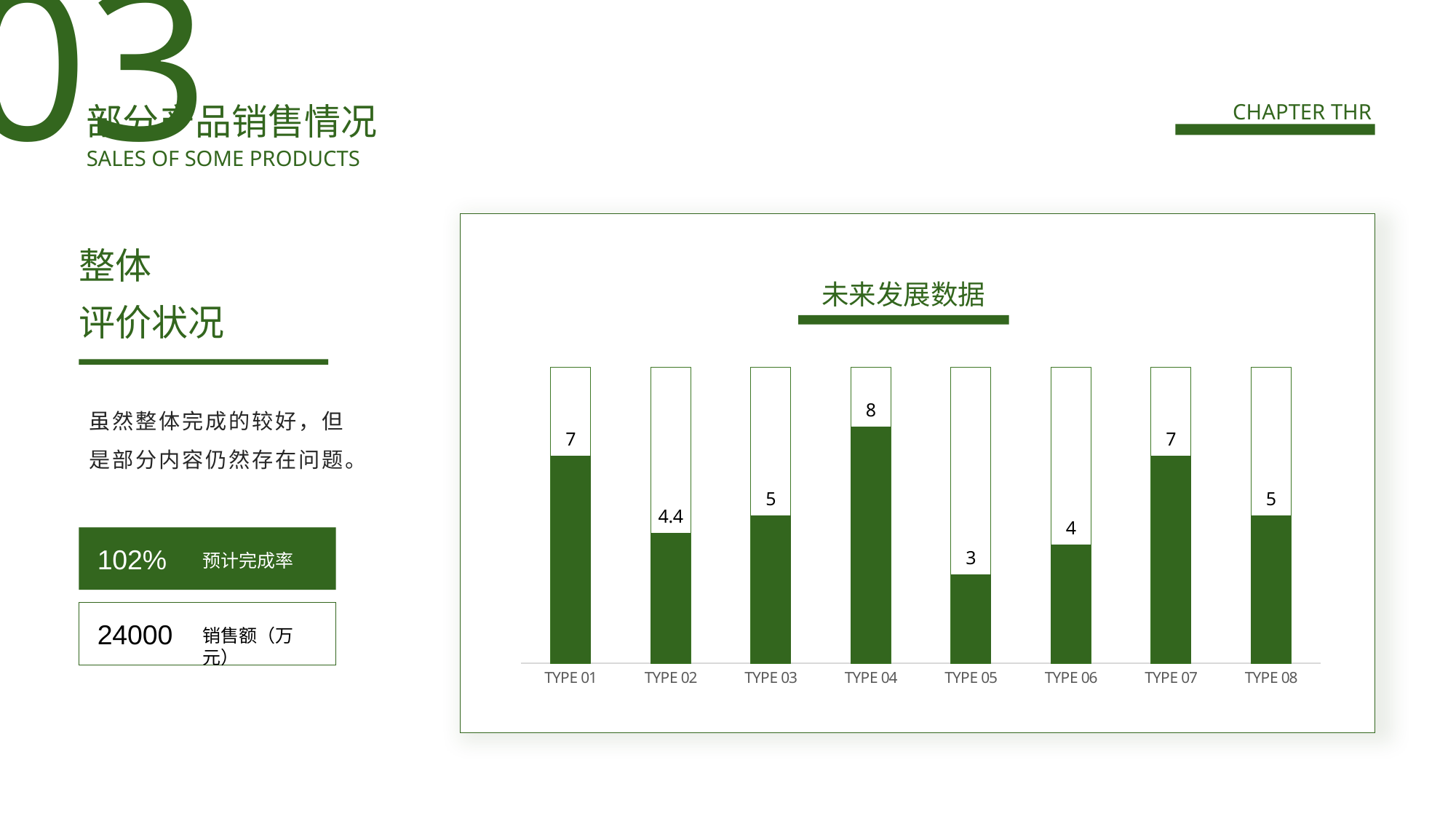
What is the value for TYPE 02? 4.4 Which category has the lowest value? TYPE 05 Which category has the highest value? TYPE 04 What is the value for TYPE 06? 4 What is the difference between the values for TYPE 03 and TYPE 02? 0.6 What is the value for TYPE 04? 8 What is the difference between the values for TYPE 04 and TYPE 05? 5 What is the title of the chart? 未来发展数据 Which two categories share the value 7? TYPE 01 and TYPE 07 Which is larger, the value for TYPE 01 or the value for TYPE 03? TYPE 01 What kind of chart is shown? Bar chart How many categories are shown on the x axis? 8